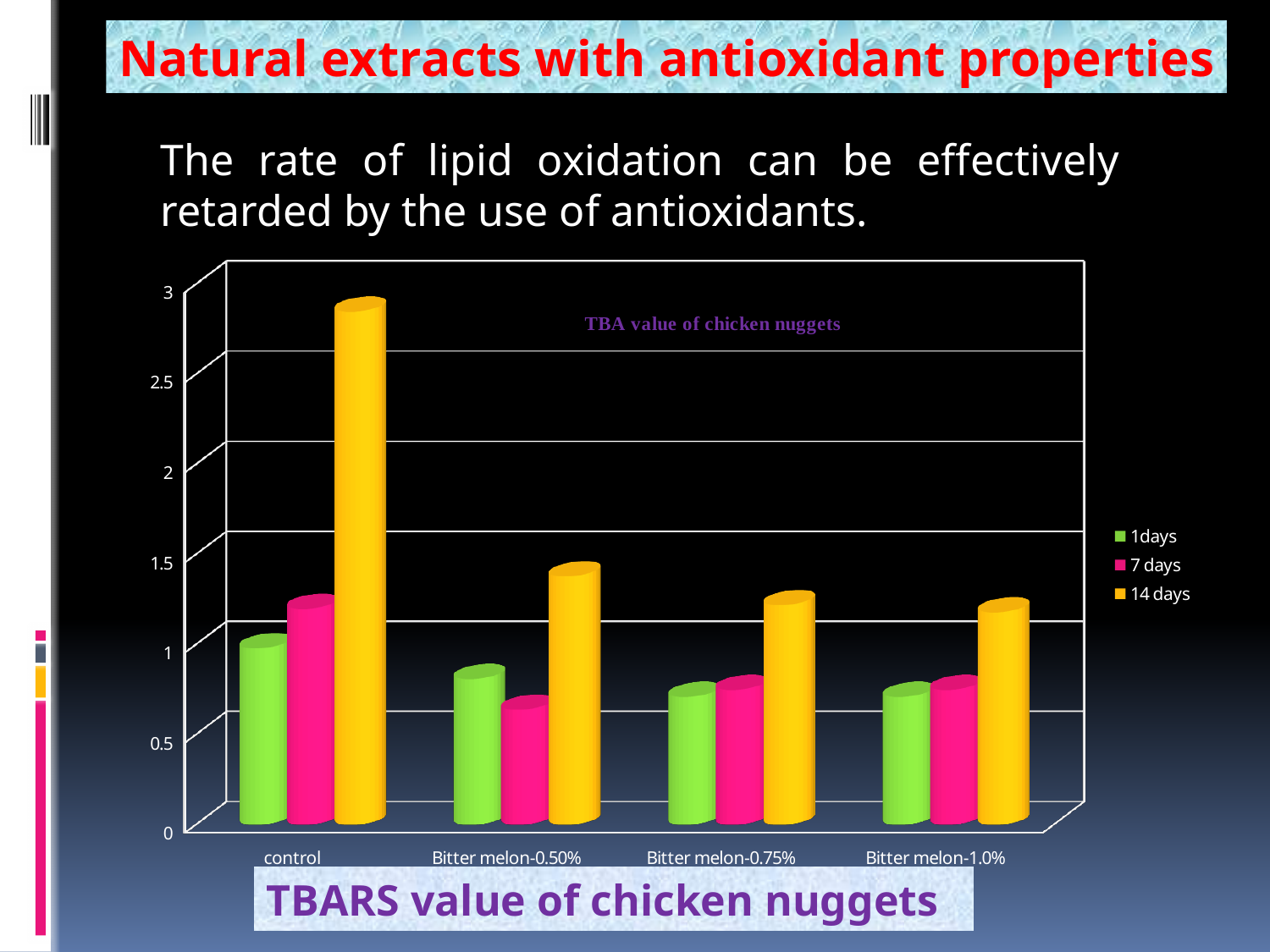
Which category has the highest value for the 14 days series? control Is the 7 days value for control greater or less than 1? greater What is the title shown inside the chart area? TBA value of chicken nuggets Is the 14 days value for Bitter melon-1.0% greater or less than 1? greater How many categories are shown on the x axis? 4 How many series does the legend list? 3 Is the 14 days value for control greater or less than 2.5? greater What kind of chart is shown on the slide? bar chart Do the 14 days values rise or fall moving from control to Bitter melon-1.0% along the x axis? fall Which category has the lowest value for the 7 days series? Bitter melon-0.50% Which is larger, the 14 days value for control or the 14 days value for Bitter melon-0.50%? control